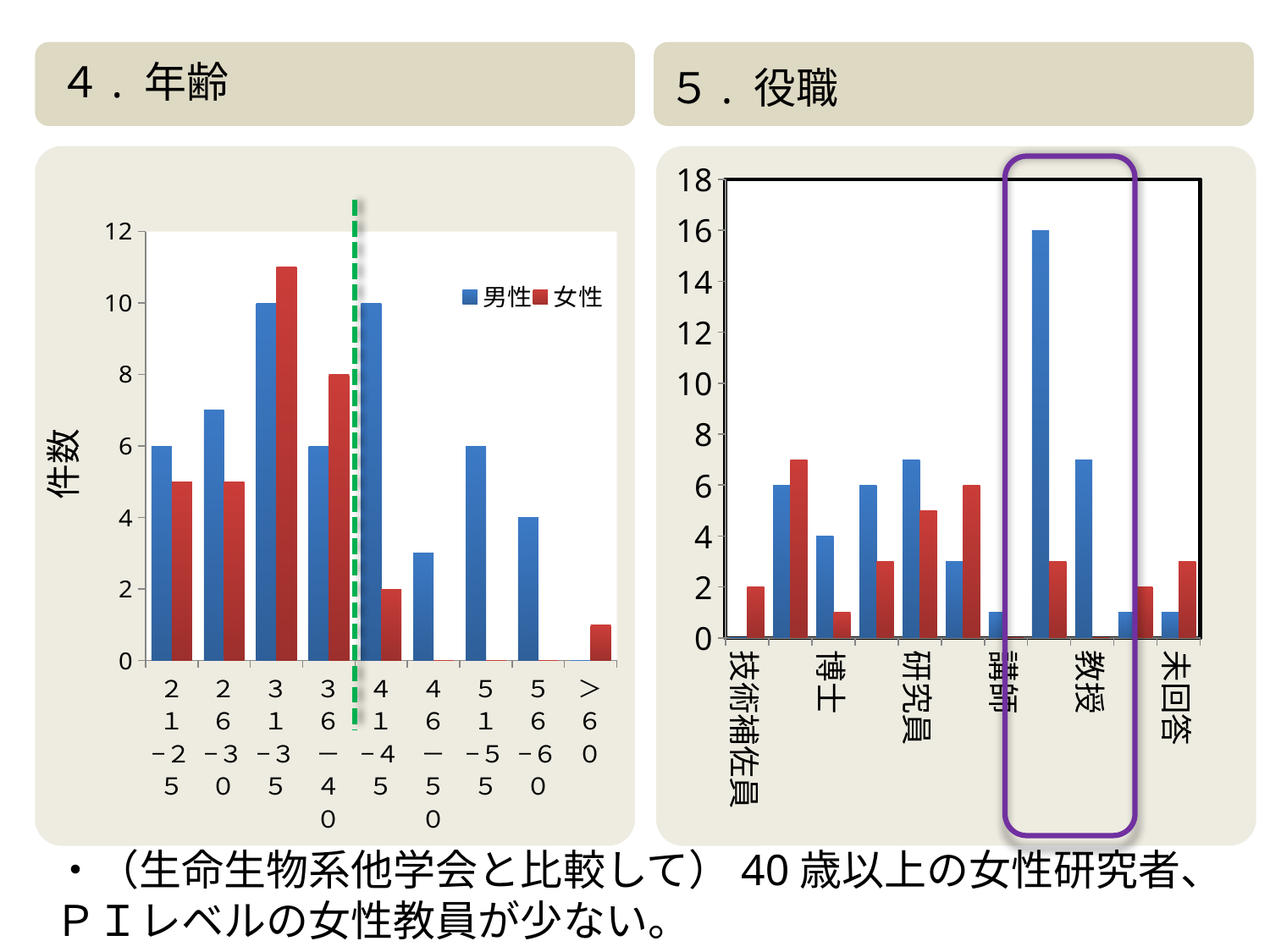
In the left chart (4. 年齢), what is the 男性 value for the 56-60 age group? 4 What kind of chart is the left chart (4. 年齢)? bar chart In the left chart (4. 年齢), what is the difference between the 男性 and 女性 values for the 41-45 age group? 8 In the left chart (4. 年齢), what is the 男性 value for the 41-45 age group? 10 In the left chart (4. 年齢), is the 女性 value for the 31-35 age group greater or less than 10? greater In the right chart (5. 役職), what is the value of the tallest bar? 16 In the left chart (4. 年齢), which age group has the highest 女性 value? 31-35 How many series does the legend of the left chart (4. 年齢) list? 2 How many age categories are shown on the x axis of the left chart (4. 年齢)? 9 In the left chart (4. 年齢), what is the 女性 value for the 41-45 age group? 2 In the left chart (4. 年齢), for the 36-40 age group, which is larger, 男性 or 女性? 女性 In the left chart (4. 年齢), what is the 女性 value for the 36-40 age group? 8